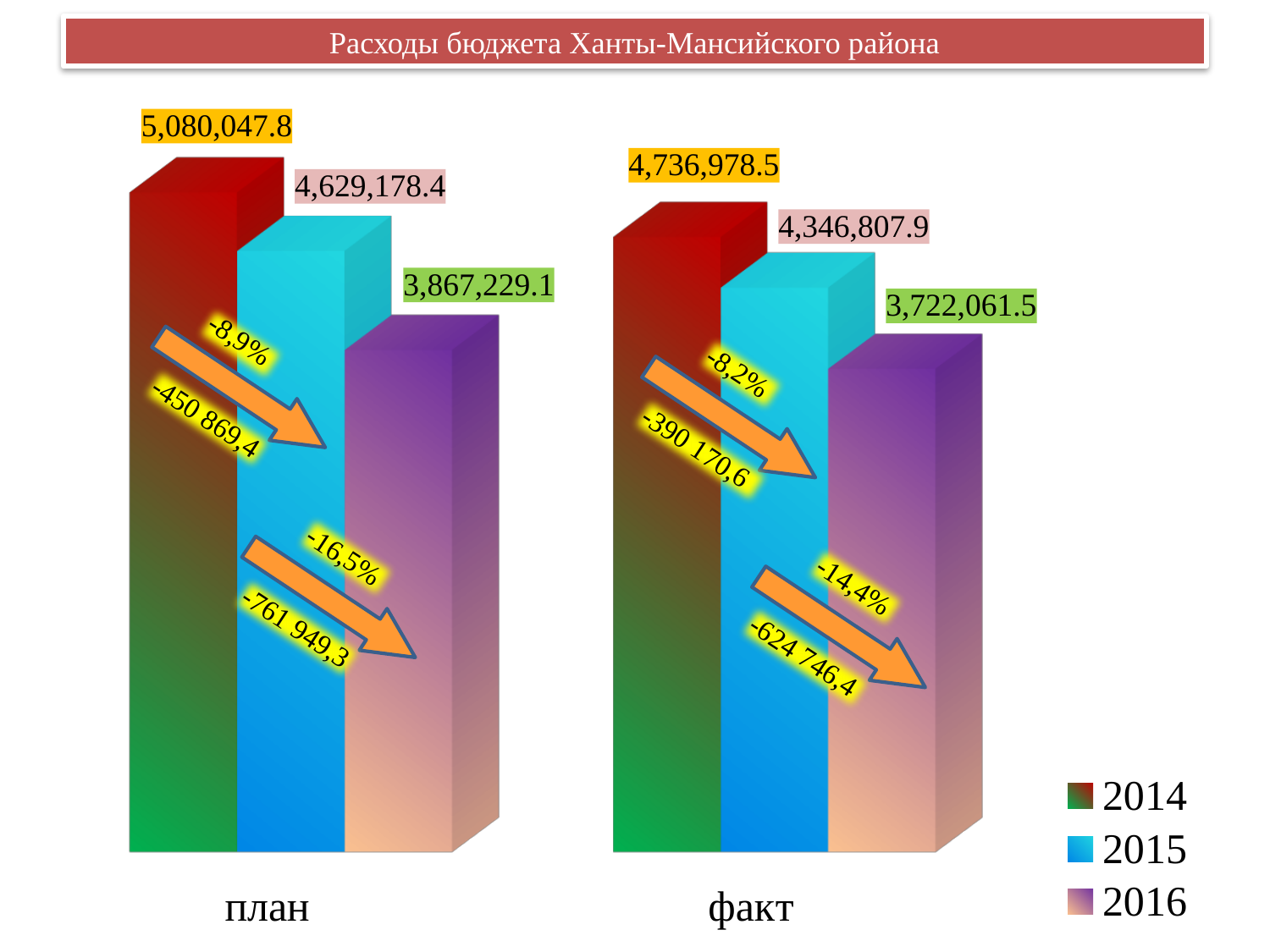
What is the title of the chart? Расходы бюджета Ханты-Мансийского района What kind of chart is shown on the slide? bar chart What is the difference between the 2015 and 2016 values in the факт category? 624,746.4 Which year has the highest value in the план category? 2014 What is the value for 2016 in the факт category? 3,722,061.5 What is the difference between the 2014 and 2015 values in the план category? 450,869.4 What is the value for 2014 in the план category? 5,080,047.8 What is the value for 2015 in the факт category? 4,346,807.9 Which year has the lowest value in the факт category? 2016 How many categories are shown on the x axis? 2 Which is larger: the 2014 value for план or the 2014 value for факт? план How many series does the legend list? 3